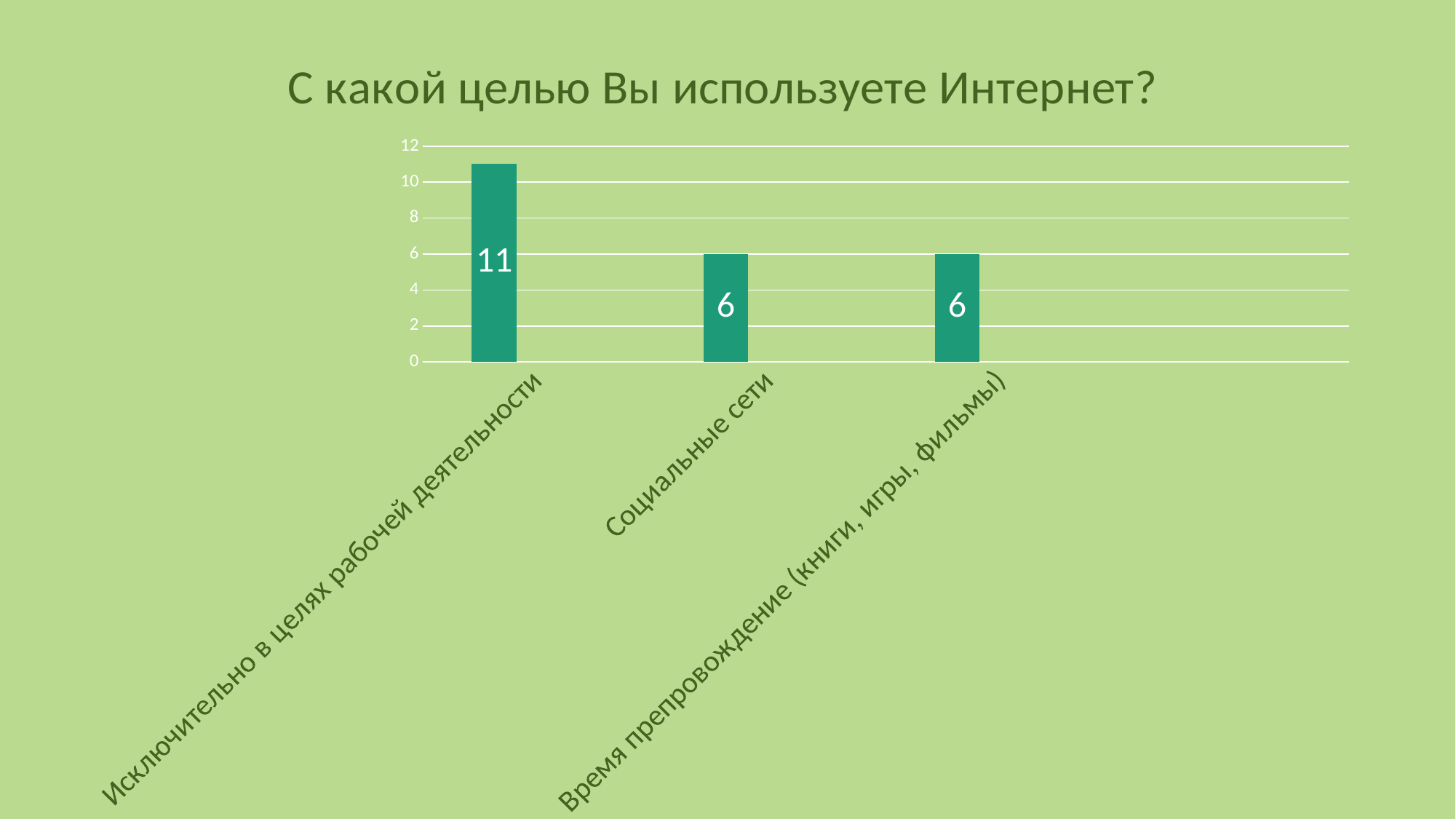
Which is larger: the value for "Исключительно в целях рабочей деятельности" or the value for "Время препровождение (книги, игры, фильмы)"? Исключительно в целях рабочей деятельности How many categories are shown on the chart? 3 What is the difference between the values for "Исключительно в целях рабочей деятельности" and "Социальные сети"? 5 What is the value for "Время препровождение (книги, игры, фильмы)"? 6 Is the value for "Социальные сети" greater or less than 8? less Which category has the highest value? Исключительно в целях рабочей деятельности Is the value for "Исключительно в целях рабочей деятельности" greater or less than 10? greater What kind of chart is shown on the slide? bar chart What is the highest value shown on the vertical axis? 12 What is the value for "Исключительно в целях рабочей деятельности"? 11 What is the value for "Социальные сети"? 6 What is the title of the chart? С какой целью Вы используете Интернет?